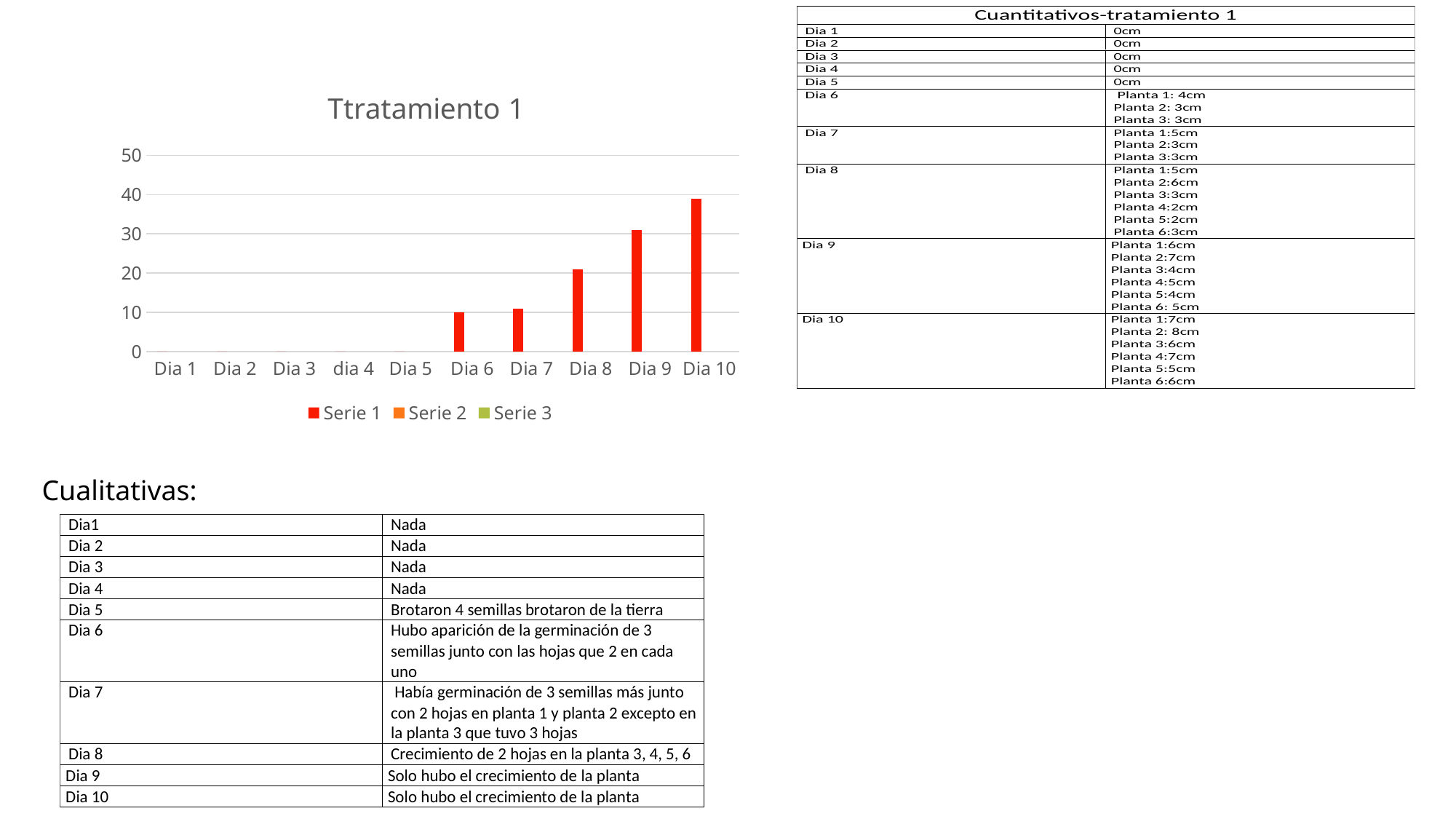
Is the value for Dia 9 greater or less than 40? less Which day has the highest bar in the chart? Dia 10 Which is larger, the value for Dia 8 or the value for Dia 9? Dia 9 Is the value for Dia 8 greater or less than 30? less What kind of chart is shown on the slide? Bar chart Is the value for Dia 10 greater or less than 30? greater How many categories are shown on the x axis of the chart? 10 What is the title of the chart? Ttratamiento 1 Do the bar values rise or fall from Dia 6 to Dia 10? rise What colour are the Serie 1 bars in the chart? Red How many series does the chart legend list? 3